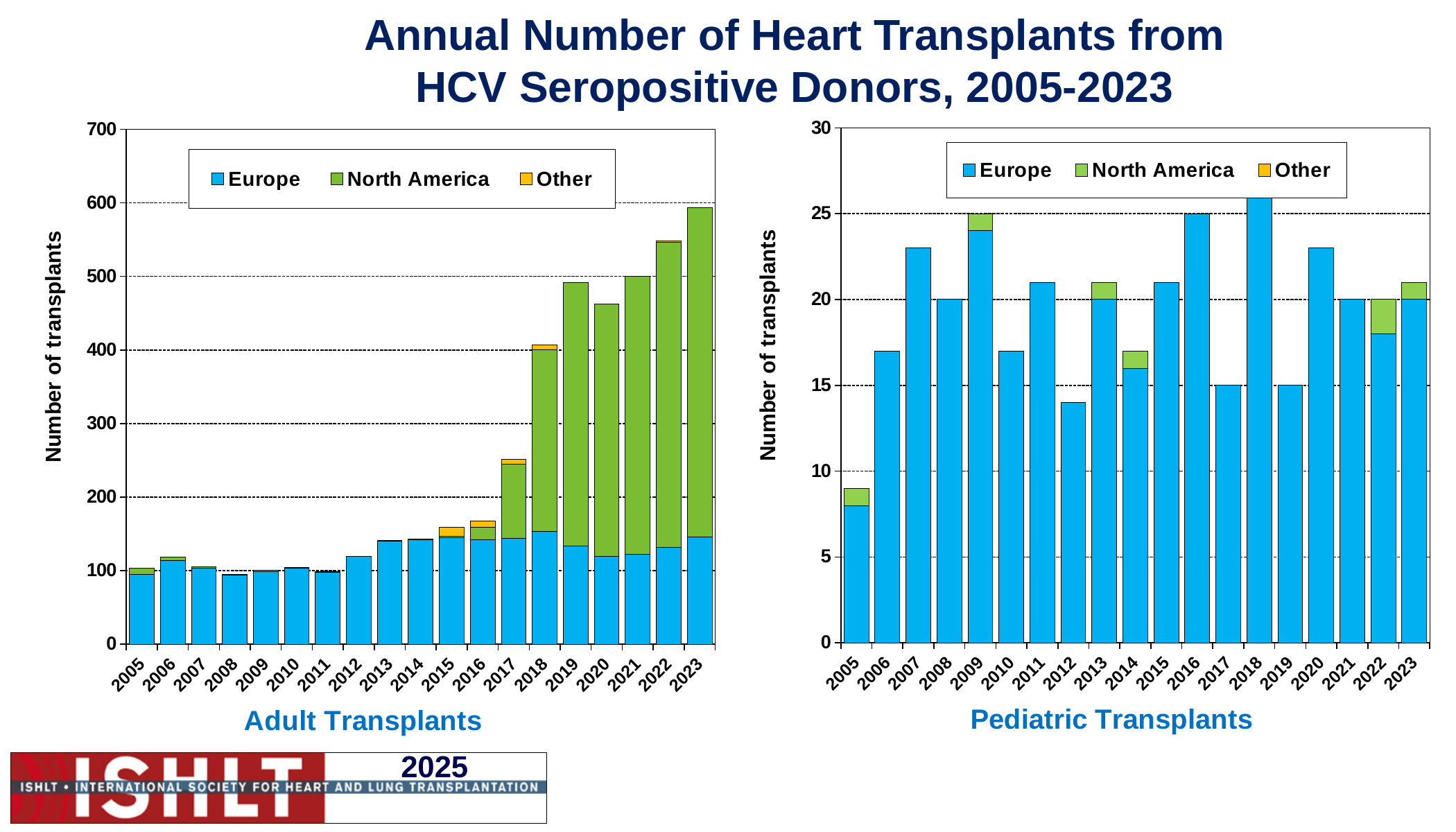
In the Adult Transplants chart, which is larger, the total for 2022 or the total for 2020? 2022 What kind of chart is the Adult Transplants chart? bar chart How many years are shown on the x axis of the Adult Transplants chart? 19 In the Adult Transplants chart, is the total for 2023 greater or less than 500? greater Which series is shown in green in the Adult Transplants chart? North America In the Pediatric Transplants chart, is the value for 2012 greater or less than 15? less In the Pediatric Transplants chart, which year has the lowest number of transplants? 2005 In the Pediatric Transplants chart, which year has the highest number of transplants? 2018 In the Adult Transplants chart, which year has the highest total number of transplants? 2023 How many series does the legend of the Pediatric Transplants chart list? 3